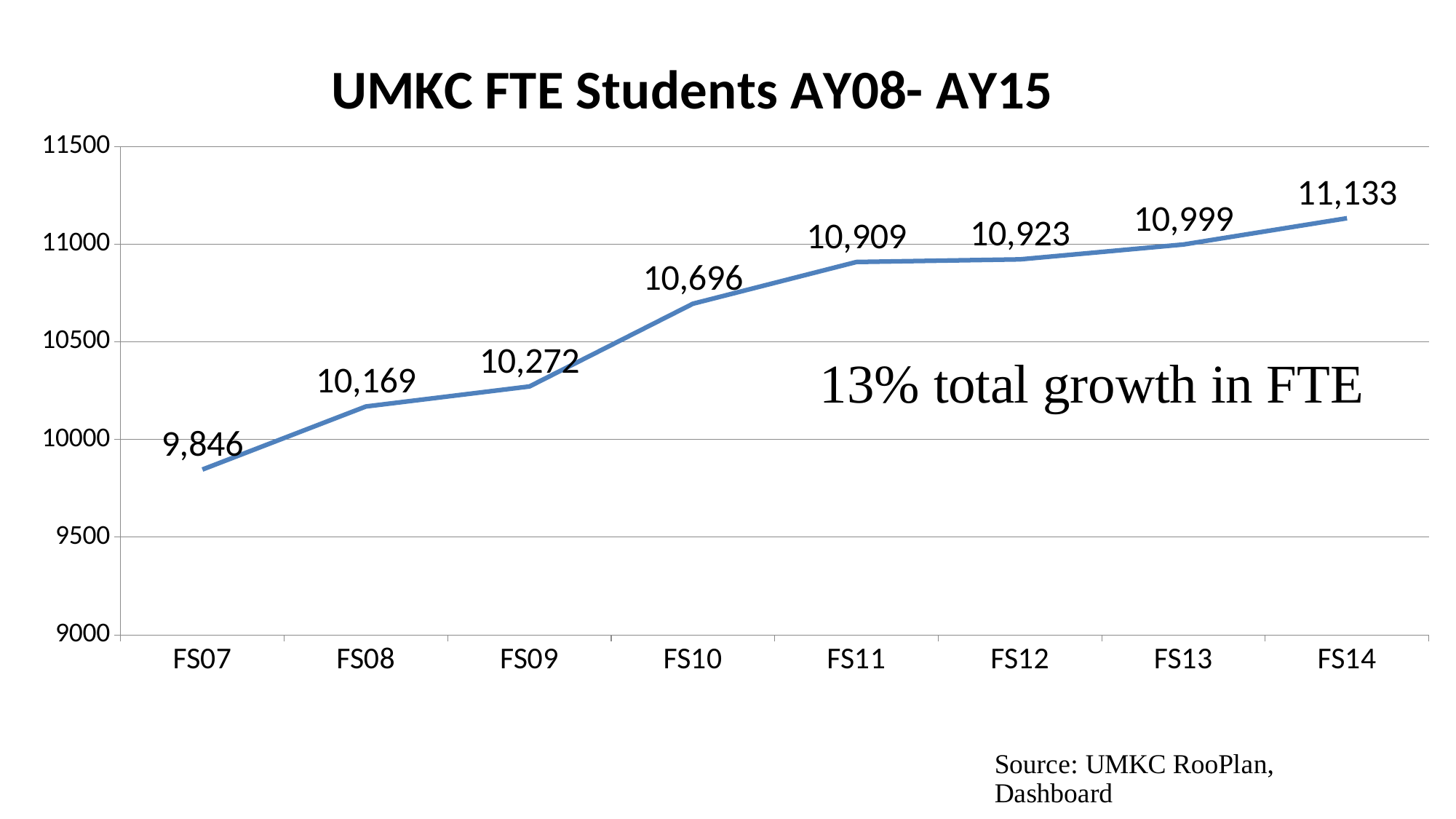
Do FTE student values rise or fall from FS07 to FS14? rise Which is larger, the FTE value for FS08 or for FS09? FS09 Which semester has the highest FTE student value? FS14 What is the FTE student value for FS10? 10,696 What kind of chart is shown on the slide? line chart Which semester has the lowest FTE student value? FS07 What is the FTE student value for FS13? 10,999 What is the FTE student value for FS07? 9,846 What is the difference in FTE students between FS14 and FS07? 1,287 What is the difference in FTE students between FS10 and FS09? 424 Is the value for FS11 greater or less than 11000? less How many semesters are plotted on the chart? 8